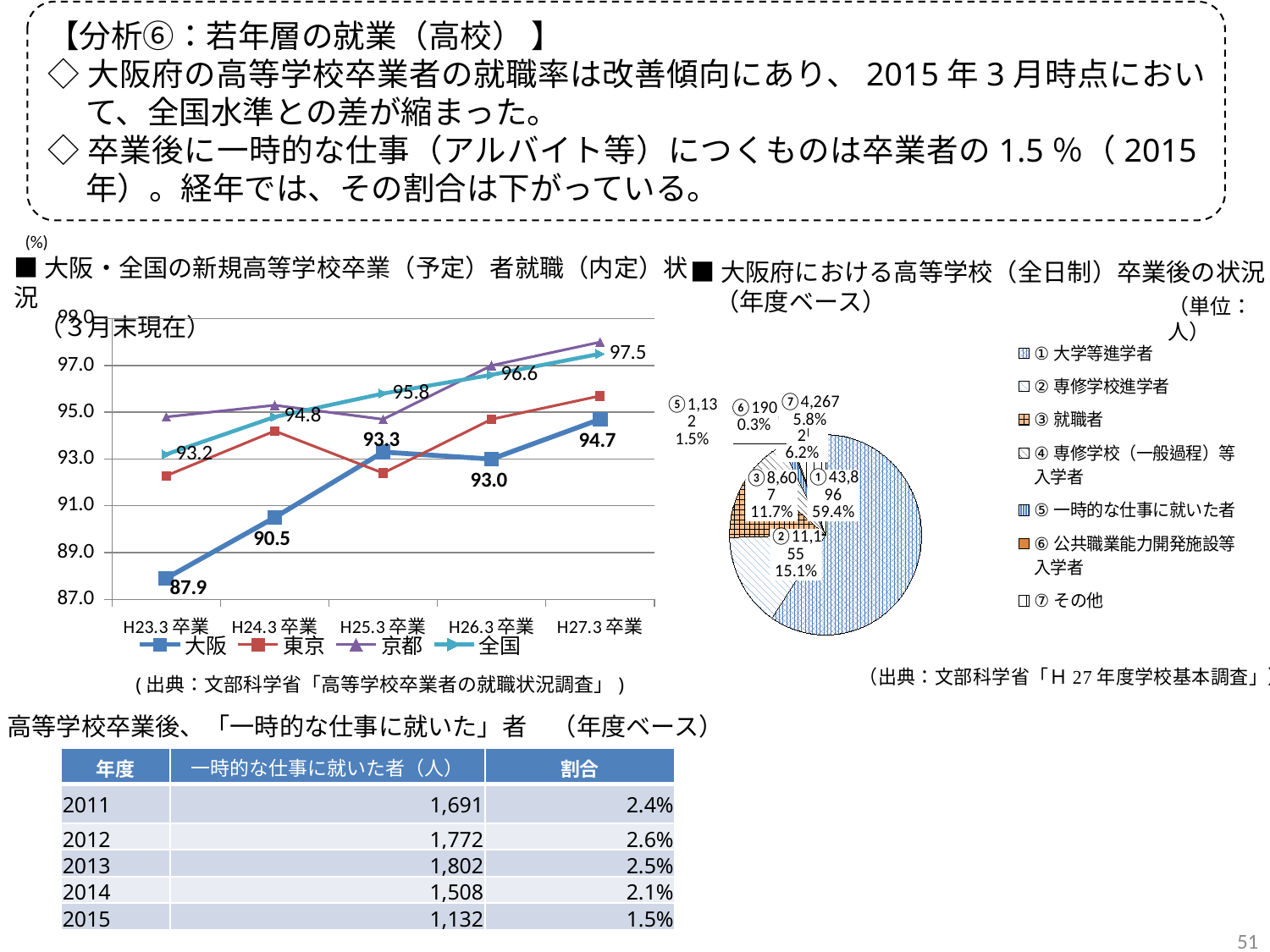
In the right pie chart, which category has the smallest slice? ⑥ 公共職業能力開発施設等入学者 How many series does the legend of the left line chart list? 4 In the left line chart, what is the difference between the 大阪 values at H27.3 卒業 and H23.3 卒業? 6.8 In the left line chart, what is the value for 大阪 at H27.3 卒業? 94.7 What kind of chart is the left chart titled 大阪・全国の新規高等学校卒業（予定）者就職（内定）状況? line chart In the left line chart, does the 全国 line rise or fall from H23.3 卒業 to H27.3 卒業? rises How many x-axis categories does the left line chart have? 5 In the left line chart, is the 大阪 value at H25.3 卒業 or at H26.3 卒業 larger? H25.3 卒業 In the right pie chart (大阪府における高等学校（全日制）卒業後の状況), what share does ① 大学等進学者 have? 59.4% In the left line chart, what is the value for 大阪 at H23.3 卒業? 87.9 In the left line chart, is the value for 東京 at H23.3 卒業 greater or less than 93.0? less In the right pie chart, what is the value for ⑤ 一時的な仕事に就いた者? 1,132